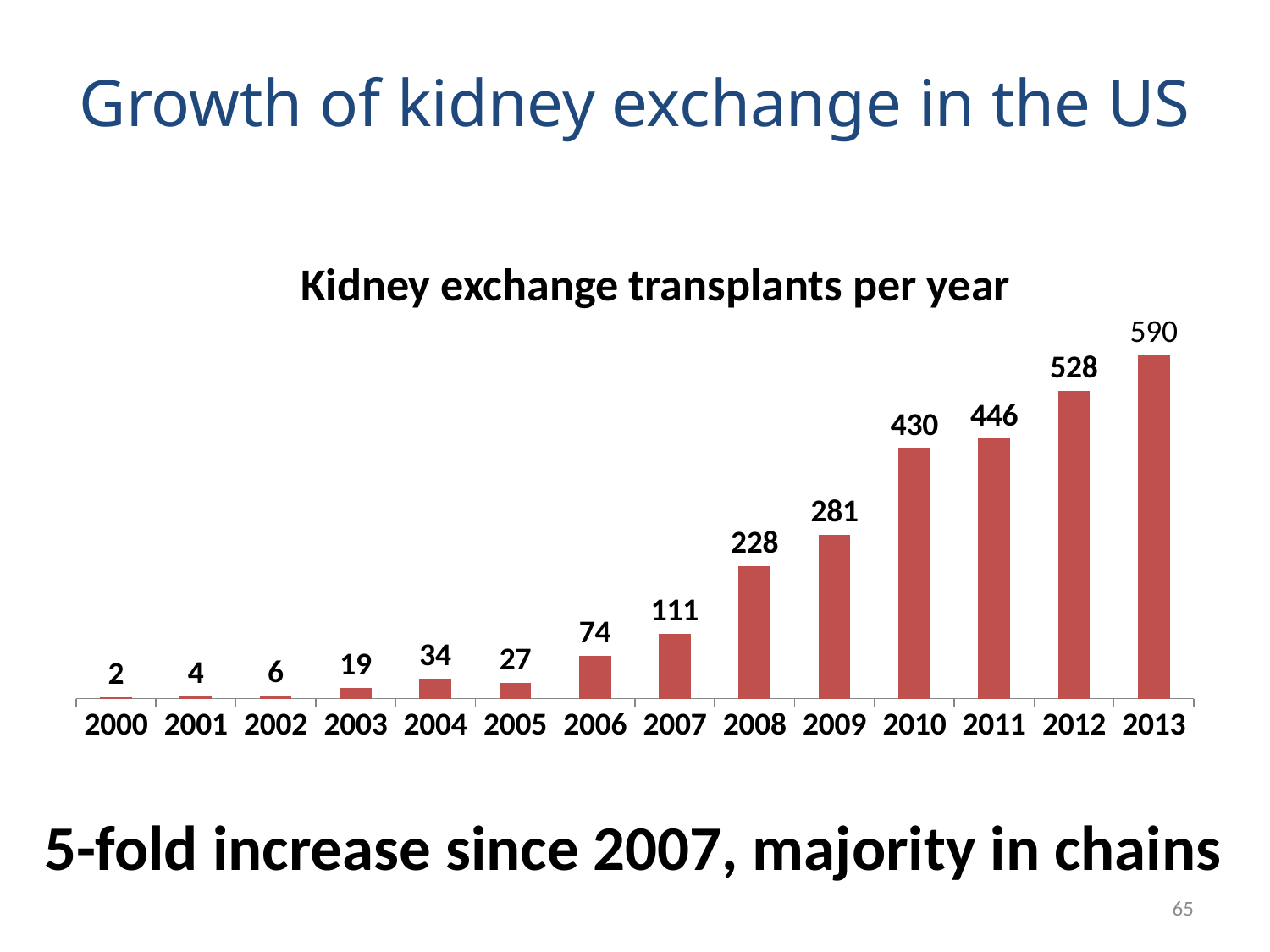
Which year has the highest number of kidney exchange transplants? 2013 What is the title of the chart? Kidney exchange transplants per year What is the difference between the number of transplants in 2012 and in 2007? 417 What is the number of kidney exchange transplants in 2008? 228 Do the values generally rise or fall from 2000 to 2013? Rise What is the number of kidney exchange transplants in 2013? 590 What colour are the bars in the chart? Red Which year had more kidney exchange transplants, 2004 or 2005? 2004 How many years are shown on the x axis of the chart? 14 What is the number of kidney exchange transplants in 2004? 34 Which year has the lowest number of kidney exchange transplants? 2000 What kind of chart is shown on the slide? Bar chart